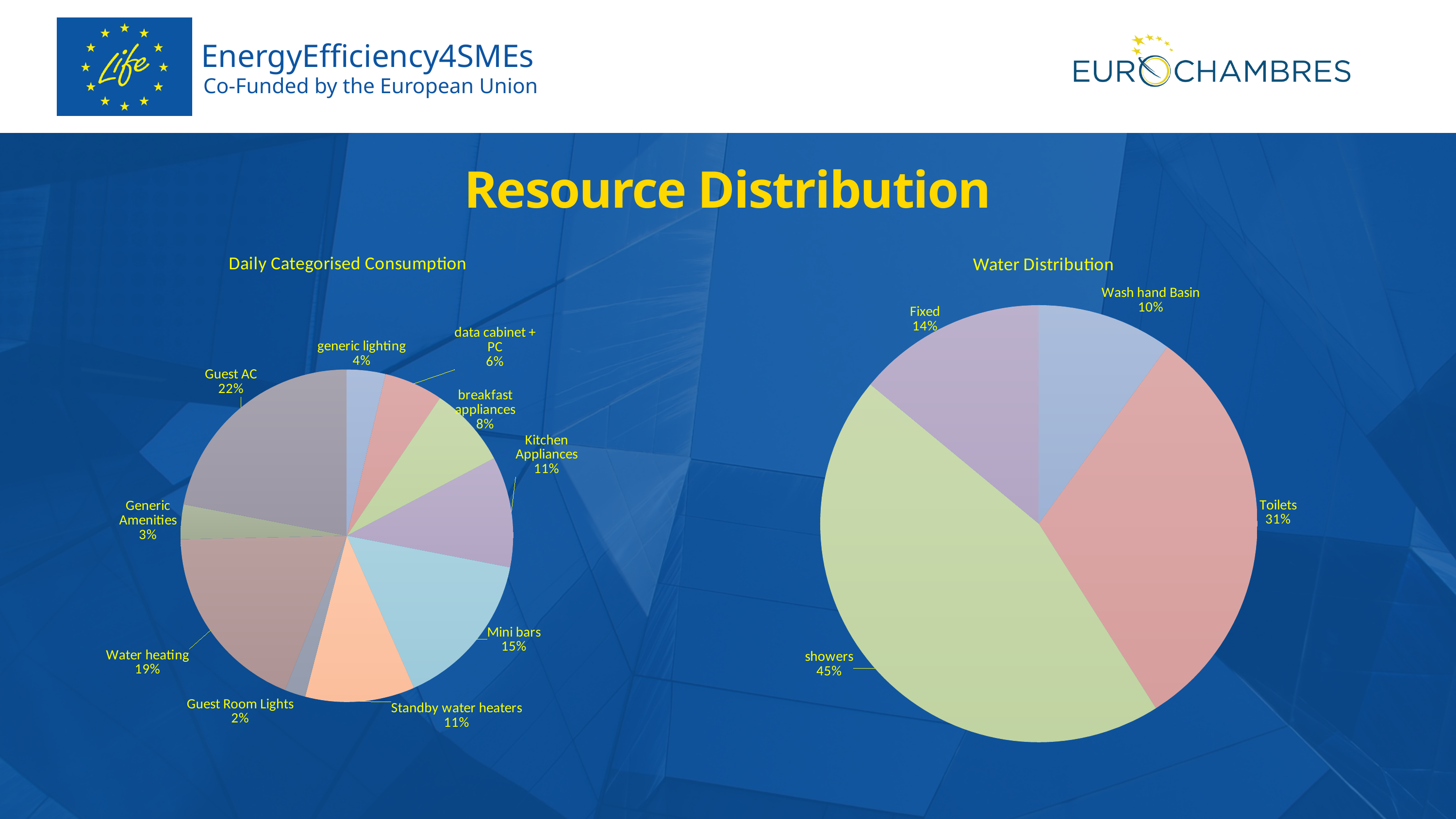
How many slices does the Daily Categorised Consumption pie chart have? 10 In the Daily Categorised Consumption chart, what is the difference between the shares of Mini bars and Kitchen Appliances? 4% In the Daily Categorised Consumption chart, what share does Guest AC have? 22% In the Daily Categorised Consumption chart, which category has the largest share? Guest AC In the Daily Categorised Consumption chart, which category has the smallest share? Guest Room Lights In the Water Distribution chart, which category has the smallest share? Wash hand Basin In the Daily Categorised Consumption chart, which is larger: breakfast appliances or data cabinet + PC? breakfast appliances In the Daily Categorised Consumption chart, what share does Water heating have? 19% In the Water Distribution chart, what is the difference between the shares of Toilets and Fixed? 17% How many slices does the Water Distribution pie chart have? 4 What type of chart is the Water Distribution chart? Pie chart In the Water Distribution chart, what share do showers have? 45%